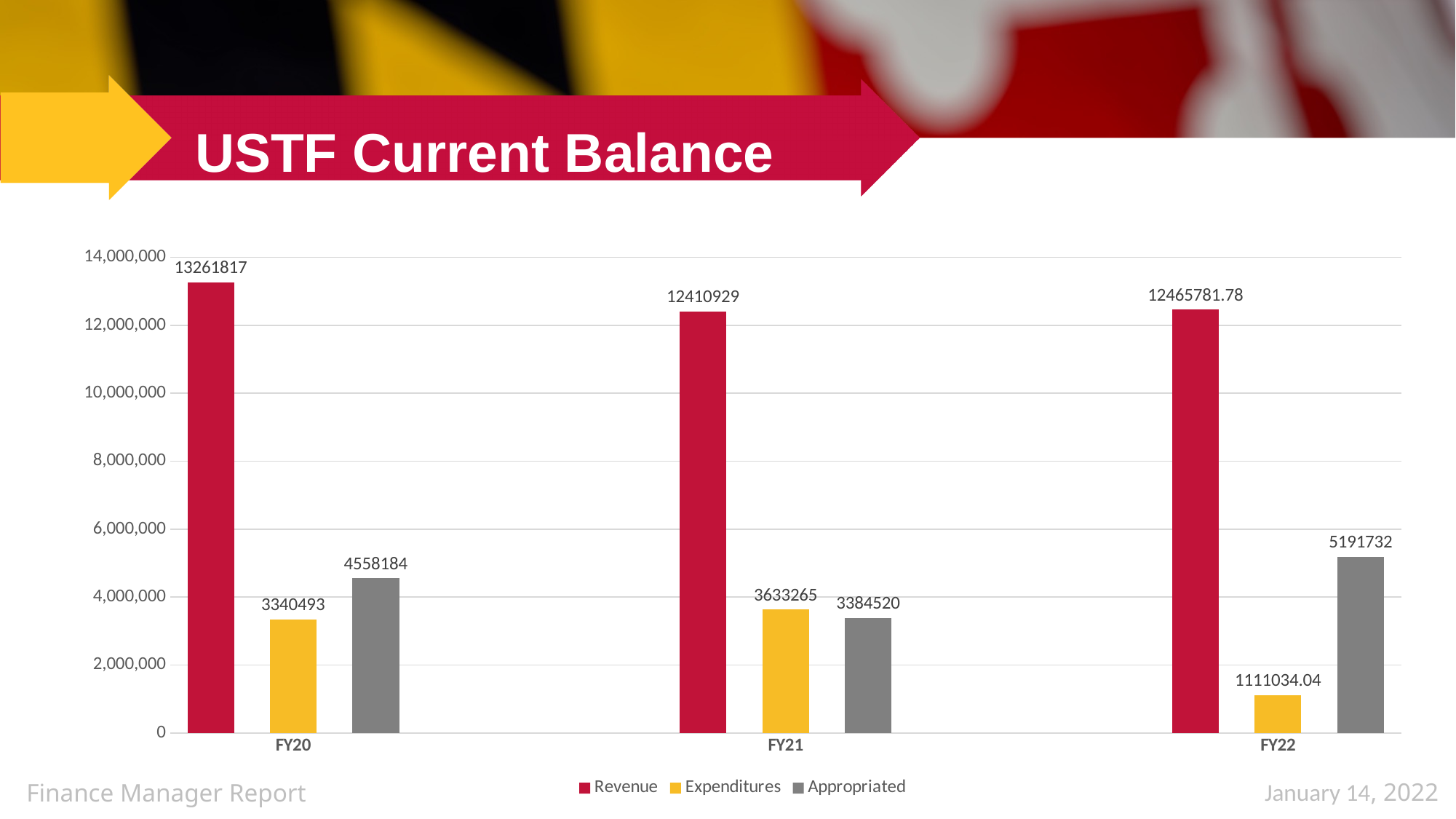
Which fiscal year has the lowest Expenditures? FY22 What type of chart is shown on the slide? bar chart What is the difference between the Appropriated and Expenditures values for FY20? 1217691 What is the Appropriated value for FY21? 3384520 What is the Revenue value for FY20? 13261817 Which fiscal year has the highest Appropriated value? FY22 What is the Expenditures value for FY22? 1111034.04 In FY21, which is larger, Expenditures or Appropriated? Expenditures Is the Expenditures value for FY22 greater or less than 2,000,000? less Which fiscal year has the highest Revenue? FY20 How many series does the legend list? 3 How much higher is Revenue in FY20 than in FY21? 850888